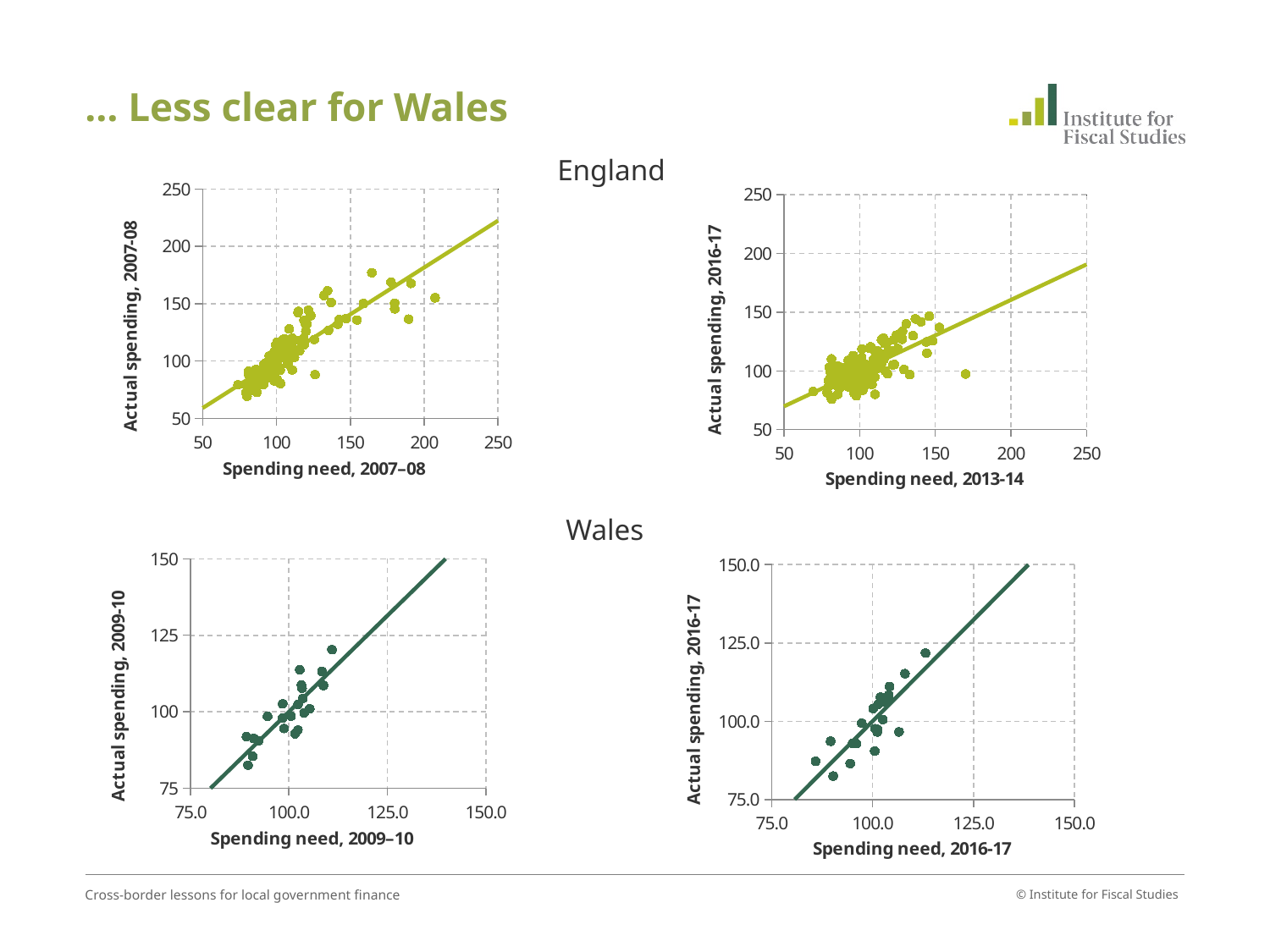
What kind of chart is the top-left chart (Actual spending, 2007-08 against Spending need, 2007–08)? scatter chart How many charts are shown on the slide? 4 In the bottom-left Wales chart (Spending need, 2009–10), do the actual spending values rise or fall as spending need increases? rise In the bottom-right Wales chart (Spending need, 2016-17), do the actual spending values rise or fall as spending need increases? rise What is the x-axis label of the top-left chart? Spending need, 2007–08 In the top-right England chart (Spending need, 2013-14), do the actual spending values rise or fall as spending need increases? rise In the bottom-left Wales chart, is the highest actual spending value plotted greater or less than 125.0? less In the bottom-right Wales chart, is the lowest actual spending value plotted greater or less than 100.0? less In the top-left England chart, is the highest actual spending value plotted greater or less than 150? greater What is the y-axis label of the top-right chart? Actual spending, 2016-17 What kind of chart is the bottom-right chart (Actual spending, 2016-17 against Spending need, 2016-17)? scatter chart